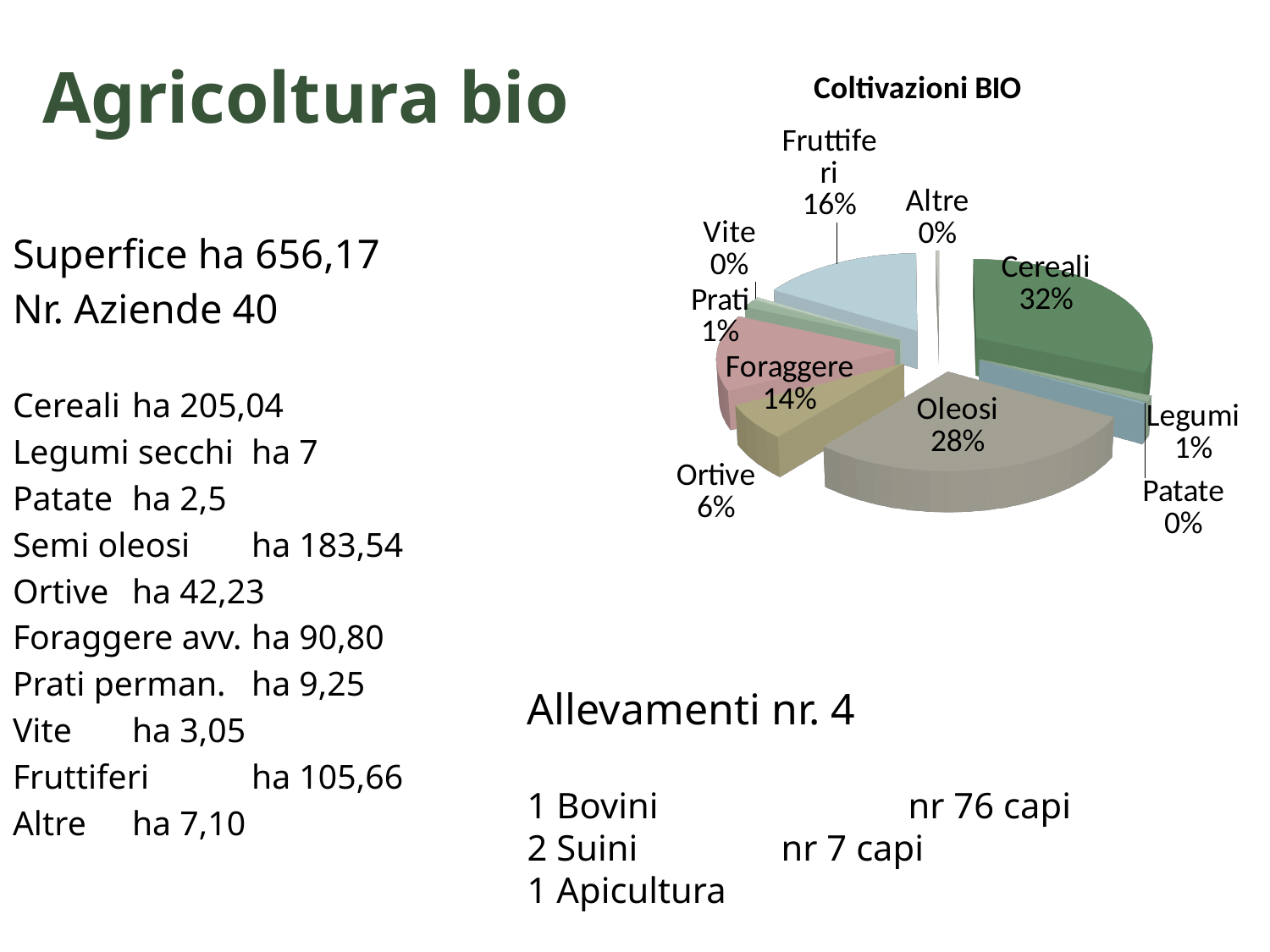
What percentage share does Legumi have in the pie chart? 1% What percentage share does Ortive have in the pie chart? 6% What is the title of the chart? Coltivazioni BIO What percentage share does Oleosi have in the pie chart? 28% What kind of chart is shown on the slide? pie chart What percentage share does Cereali have in the pie chart? 32% How many slices (categories) are labelled in the pie chart? 10 What percentage share does Foraggere have in the pie chart? 14% What percentage share does Fruttiferi have in the pie chart? 16% Which is larger in the pie chart, Fruttiferi or Foraggere? Fruttiferi Which category has the largest slice in the pie chart? Cereali What is the difference in percentage points between Cereali and Oleosi? 4